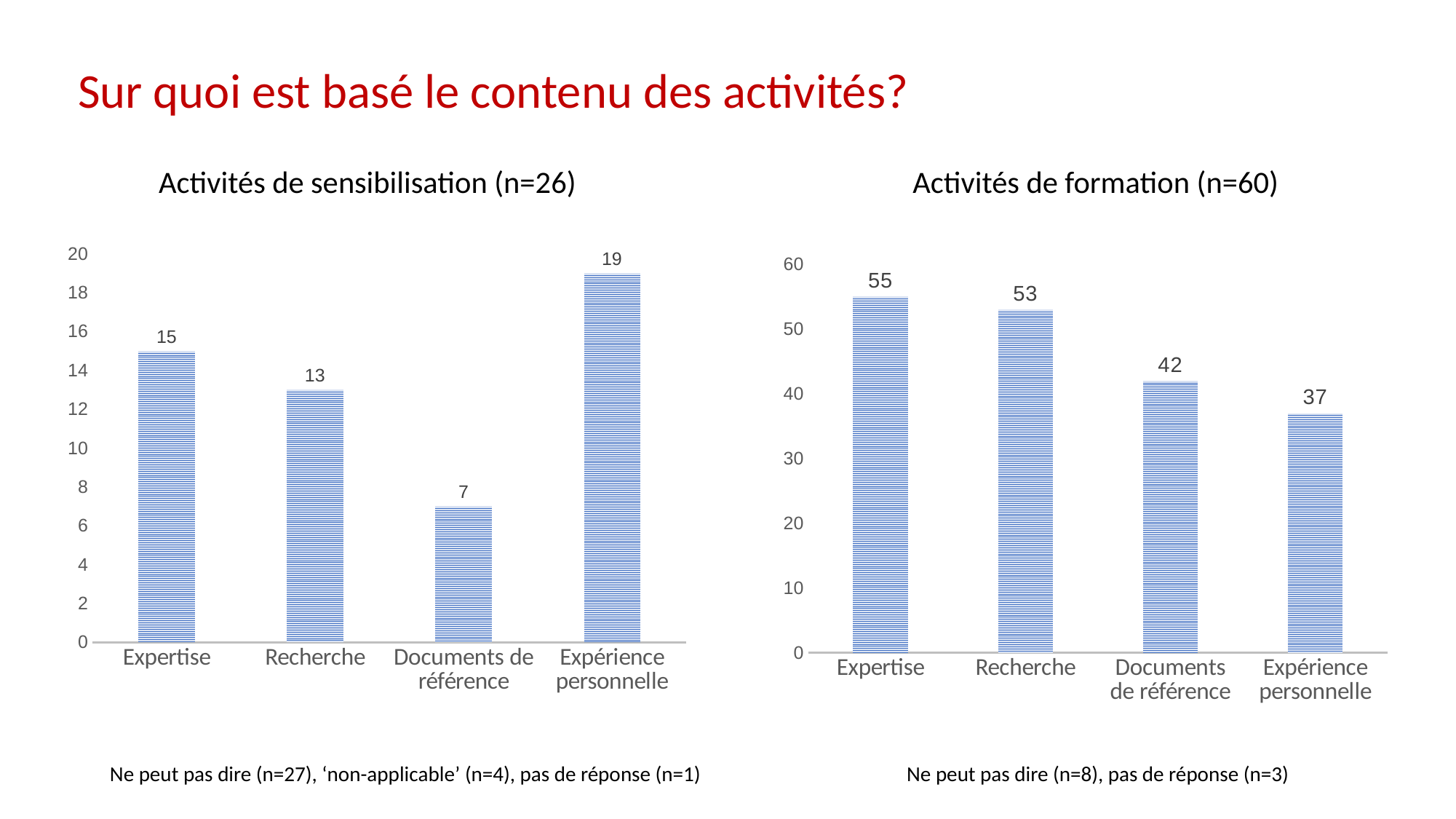
In the 'Activités de formation (n=60)' chart, what is the difference between Expertise and Expérience personnelle? 18 In the 'Activités de formation (n=60)' chart, what is the value for Documents de référence? 42 What kind of chart is the 'Activités de sensibilisation (n=26)' chart? bar chart How many categories are shown in the 'Activités de formation (n=60)' chart? 4 In the 'Activités de sensibilisation (n=26)' chart, what is the difference between Expérience personnelle and Documents de référence? 12 In the 'Activités de sensibilisation (n=26)' chart, which category has the lowest value? Documents de référence In the 'Activités de formation (n=60)' chart, which category has the lowest value? Expérience personnelle In the 'Activités de sensibilisation (n=26)' chart, which category has the highest value? Expérience personnelle In the 'Activités de formation (n=60)' chart, do the values rise or fall from left to right? fall In the 'Activités de formation (n=60)' chart, which is larger: Recherche or Documents de référence? Recherche In the 'Activités de sensibilisation (n=26)' chart, is the value for Recherche greater or less than 10? greater In the 'Activités de sensibilisation (n=26)' chart, what is the value for Expertise? 15